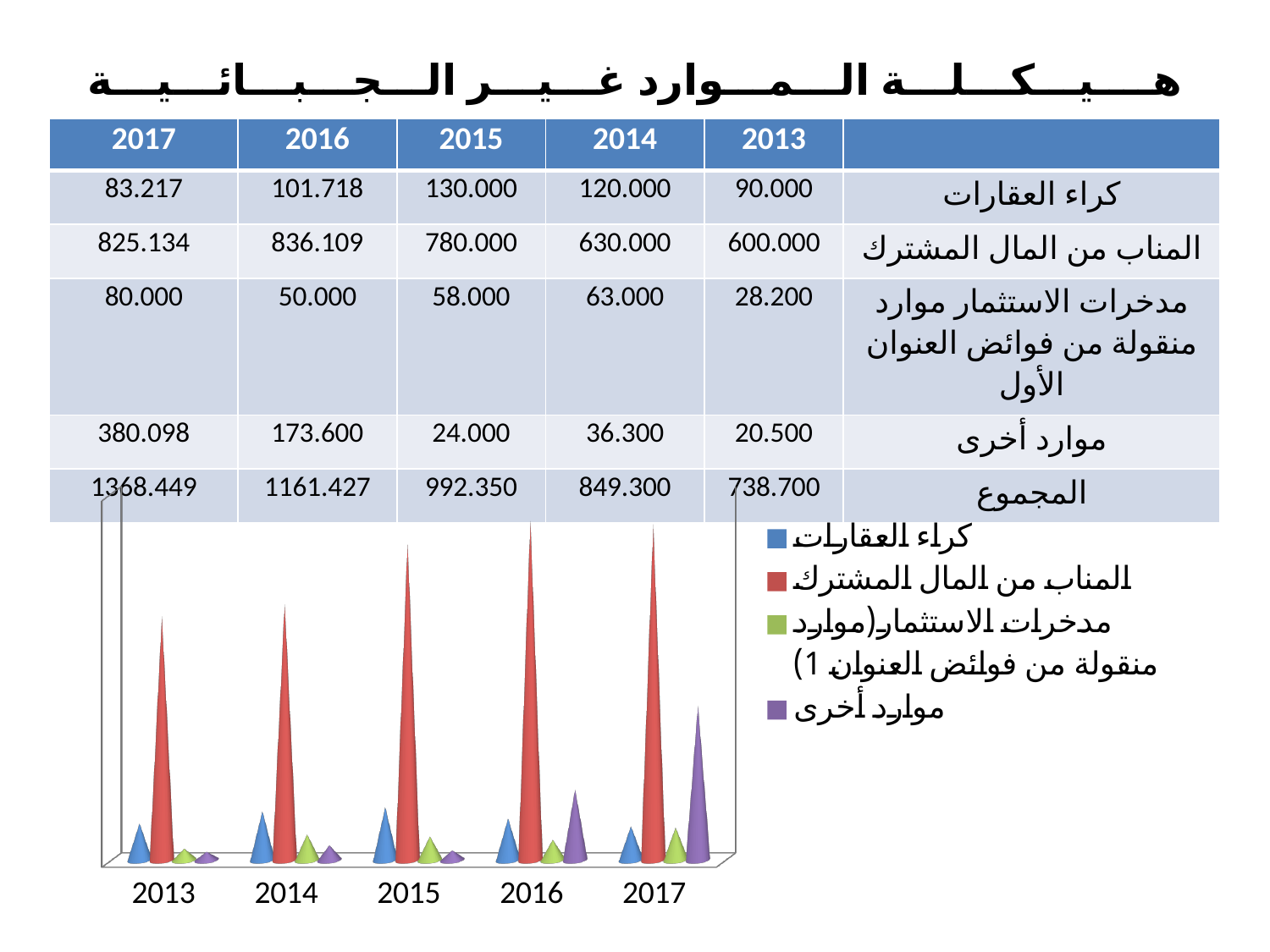
In which year is the bar for موارد أخرى the tallest? 2017 Which series has the tallest bar in 2017? المناب من المال المشترك Does the value for موارد أخرى rise or fall from 2015 to 2017? rises According to the table on the slide, what is the value of المناب من المال المشترك in 2015? 780.000 What kind of chart is shown on the slide? bar chart According to the table on the slide, what is the المجموع (total) for 2017? 1368.449 How many years are shown along the x axis of the chart? 5 What colour represents المناب من المال المشترك in the chart? red How many series does the chart legend list? 4 In 2013, which is larger: كراء العقارات or موارد أخرى? كراء العقارات In 2017, which is larger: موارد أخرى or كراء العقارات? موارد أخرى According to the table on the slide, what is the value of موارد أخرى in 2017? 380.098